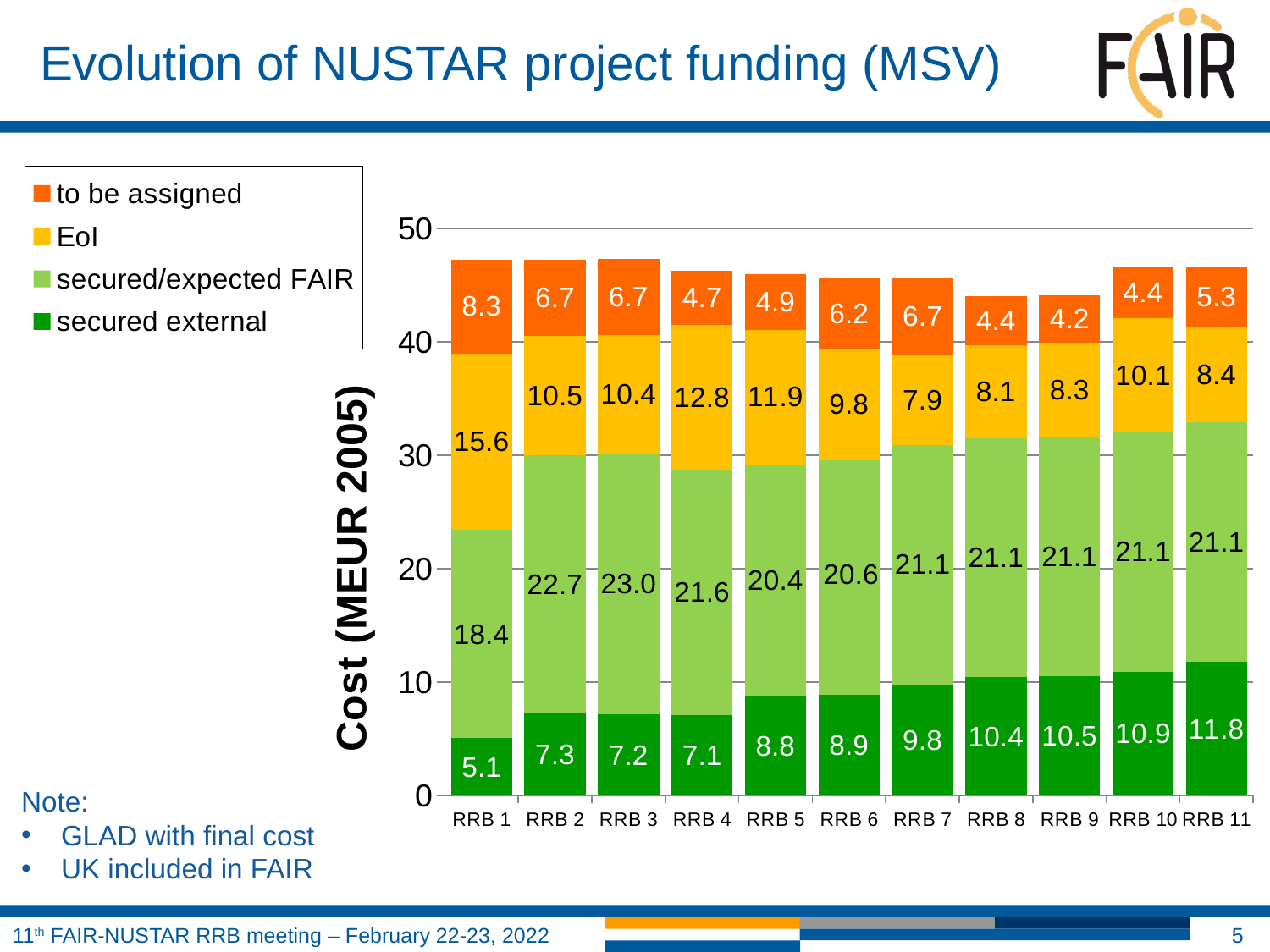
Which is larger, the EoI value for RRB 2 or for RRB 7? RRB 2 What is the total of the stacked bar for RRB 1? 47.4 Does the secured external value rise or fall from RRB 1 to RRB 11? Rise What is the difference between the secured external values for RRB 11 and RRB 1? 6.7 How many RRB categories are shown on the x axis? 11 Which RRB has the lowest secured/expected FAIR value? RRB 1 How many series does the legend list? 4 Which RRB has the highest secured external value? RRB 11 What is the EoI value for RRB 4? 12.8 What is the value of the secured external series for RRB 1? 5.1 What kind of chart is shown on the slide? Stacked bar chart What is the 'to be assigned' value for RRB 11? 5.3